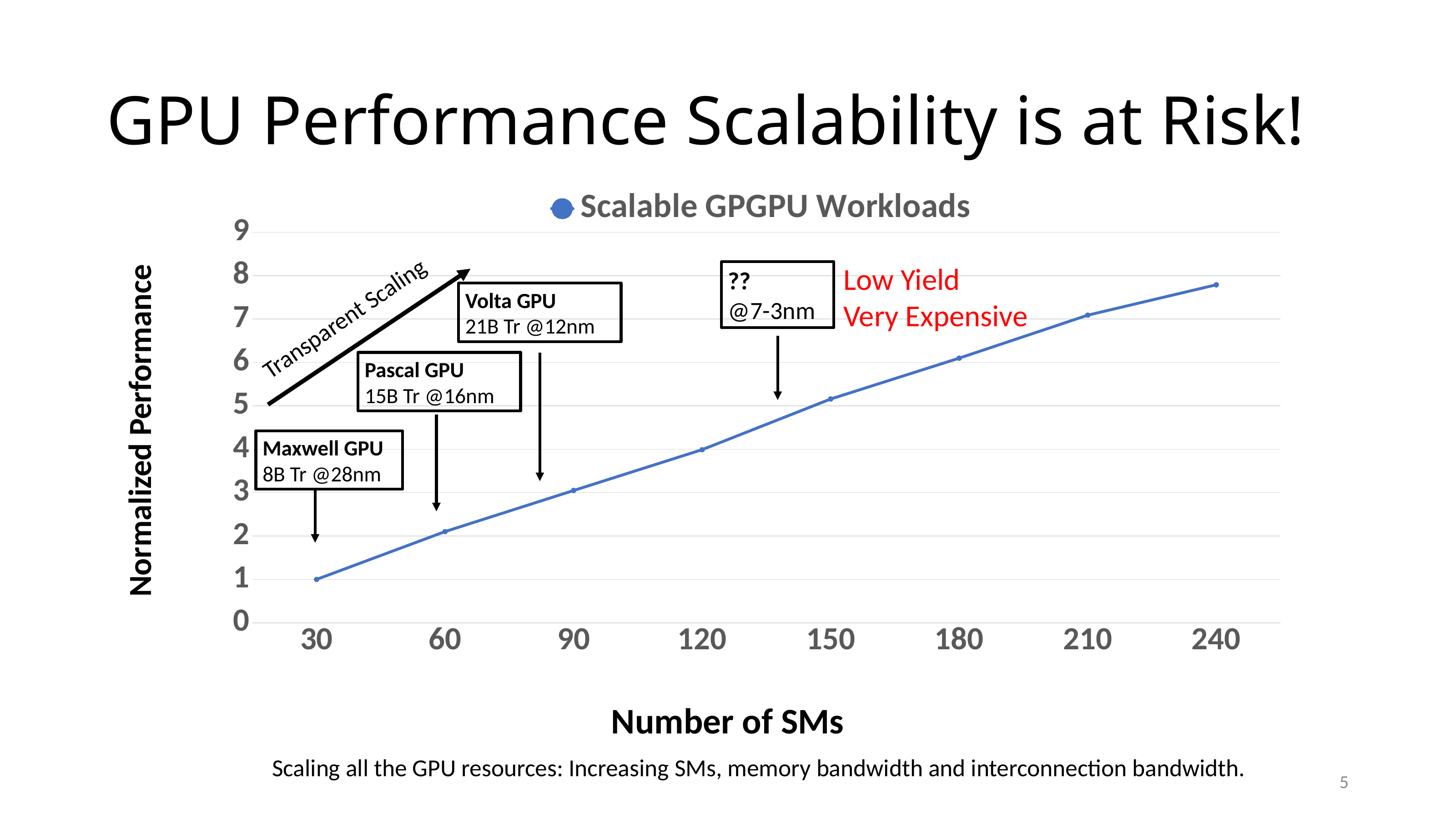
At which number of SMs is normalized performance highest? 240 How many series does the legend list? 1 How many data points are plotted on the line? 8 Is the normalized performance at 240 SMs greater or less than 8? less What type of chart is shown on the slide? line chart What is the name of the series shown in the legend? Scalable GPGPU Workloads Does normalized performance rise or fall as the number of SMs increases? rise Is the normalized performance at 60 SMs greater or less than 2? greater Is the normalized performance at 150 SMs greater or less than 5? greater What is the normalized performance at 30 SMs? 1